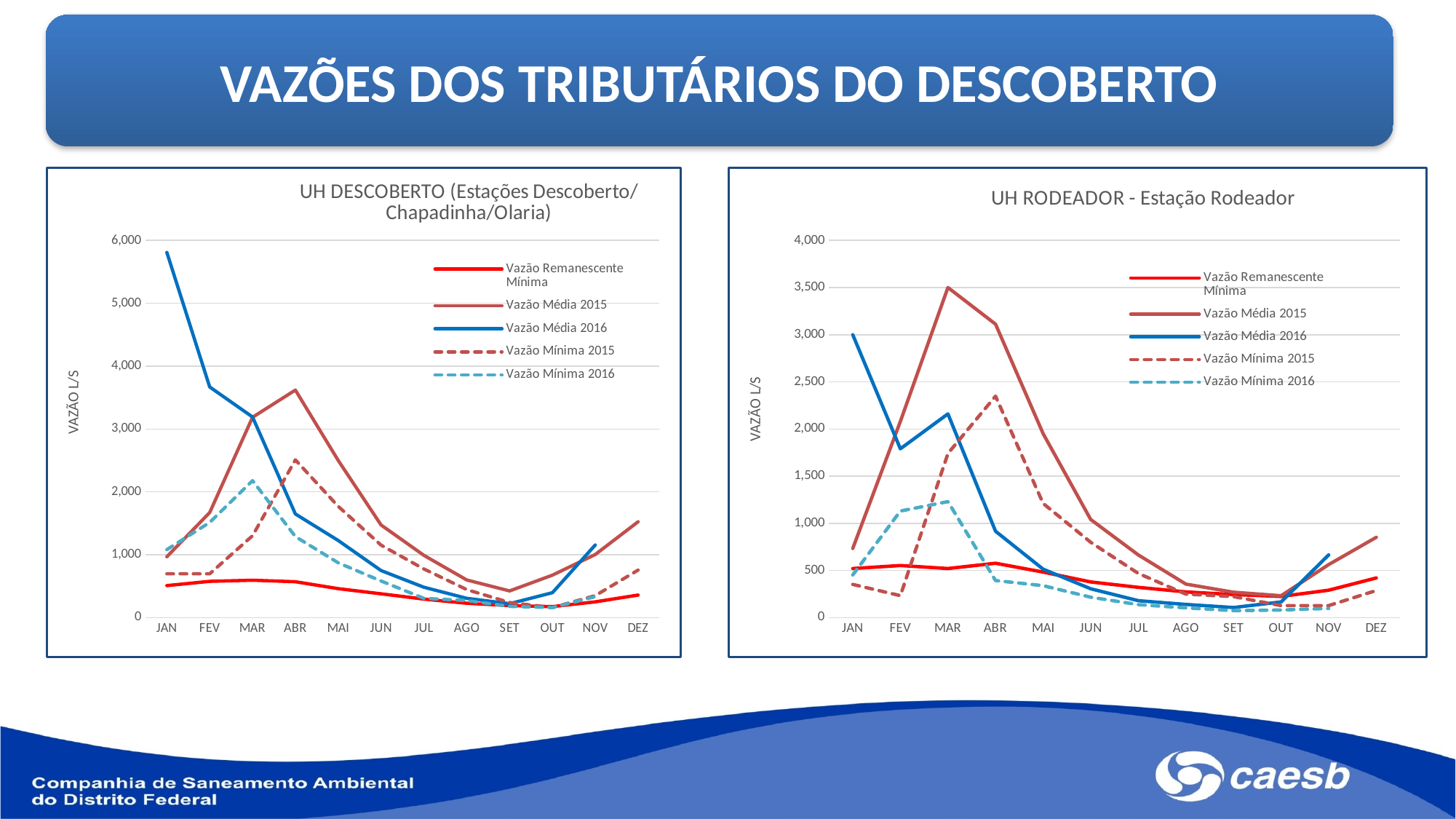
In the UH DESCOBERTO chart, is the Vazão Média 2016 value for JAN greater or less than 5,000? greater What type of chart is the UH DESCOBERTO chart on the left? line chart In the UH DESCOBERTO chart, in which month is Vazão Mínima 2016 highest? MAR In the UH RODEADOR chart, which is larger in JAN: Vazão Média 2016 or Vazão Média 2015? Vazão Média 2016 In the UH DESCOBERTO chart, does Vazão Média 2016 rise or fall from JAN to SET? fall In the UH RODEADOR chart, is the Vazão Média 2015 value for MAR greater or less than 3,000? greater What is the y-axis label on the UH RODEADOR chart? VAZÃO L/S In the UH DESCOBERTO chart, in which month does Vazão Média 2015 reach its peak? ABR In the UH DESCOBERTO chart, in which month is Vazão Média 2016 highest? JAN How many months are shown on the x axis of the UH DESCOBERTO chart? 12 How many series does the legend of the UH RODEADOR chart list? 5